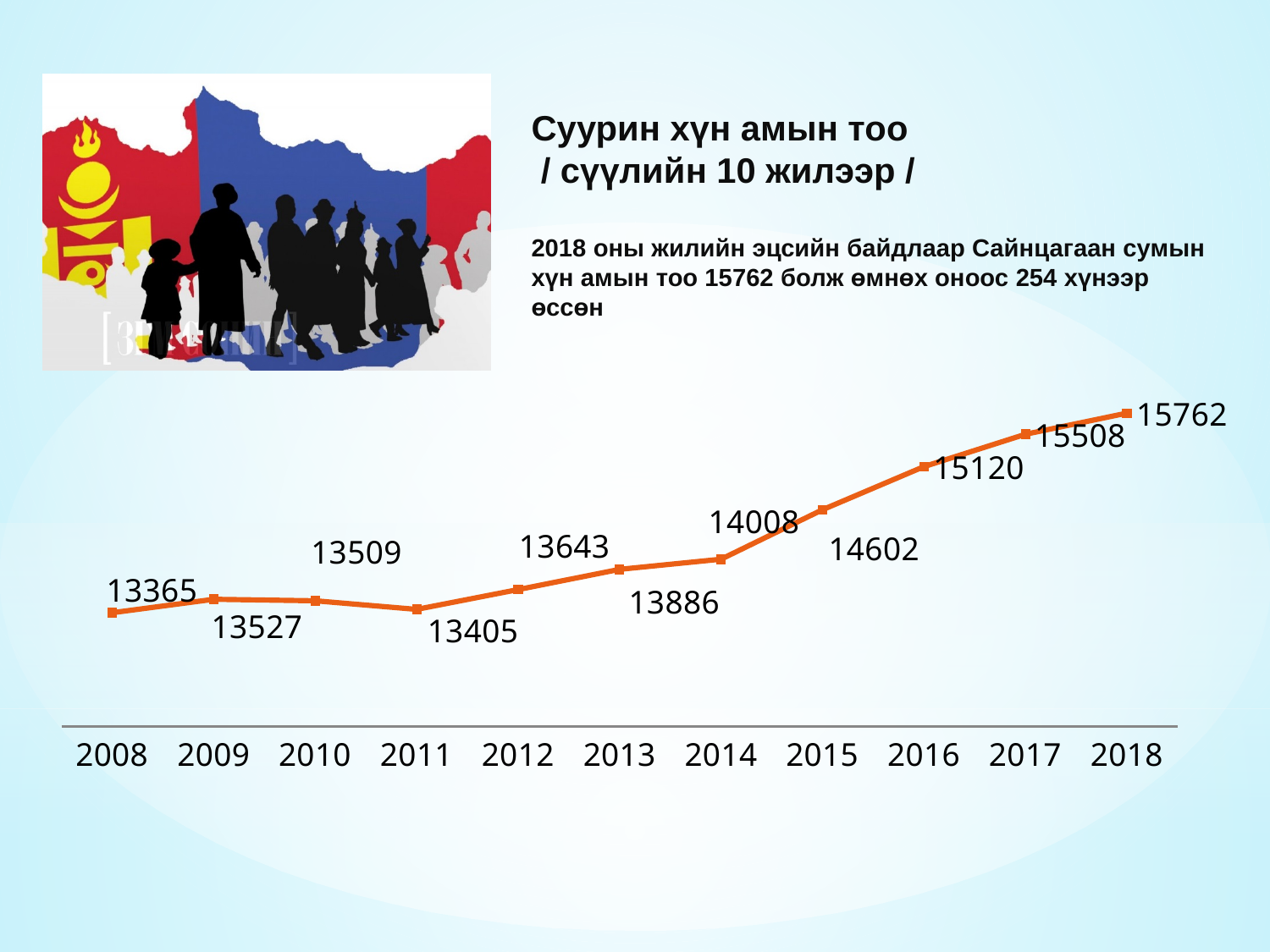
What is the difference between the values for 2018 and 2017? 254 What type of chart is shown on the slide? line chart What is the value for 2011? 13405 Which is larger, the value for 2009 or the value for 2010? 2009 What is the value for 2015? 14602 Do the values generally rise or fall from 2011 to 2018? rise Which year has the lowest value? 2008 What is the value for 2008? 13365 How many years are plotted on the x axis? 11 What is the value for 2018? 15762 Which year has the highest value? 2018 What is the difference between the values for 2016 and 2015? 518